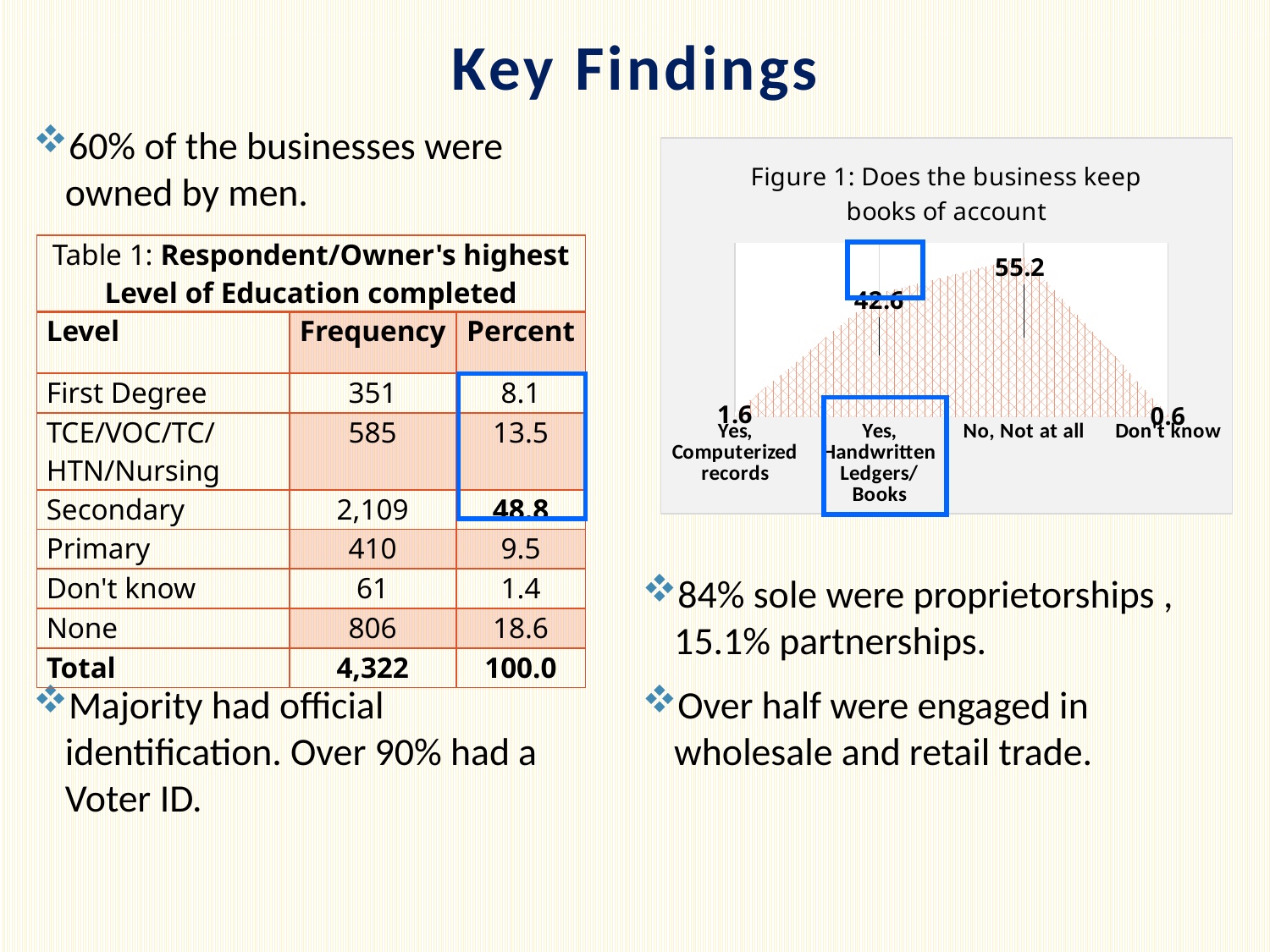
In Figure 1, what is the difference between the values for "No, Not at all" and "Yes, Handwritten Ledgers/Books"? 12.6 What kind of chart is Figure 1? area chart In Figure 1, what is the difference between the values for "Yes, Computerized records" and "Don't know"? 1.0 In Figure 1, which category has the lowest value? Don't know In Figure 1, what is the value for "No, Not at all"? 55.2 In Figure 1, which is larger: the value for "Yes, Computerized records" or the value for "Don't know"? Yes, Computerized records In Figure 1, which category has the highest value? No, Not at all What is the title of the chart on the slide? Figure 1: Does the business keep books of account In Figure 1, what is the value for "Yes, Computerized records"? 1.6 How many categories are plotted in Figure 1? 4 In Figure 1, what is the value for "Yes, Handwritten Ledgers/Books"? 42.6 In Figure 1, what is the value for "Don't know"? 0.6